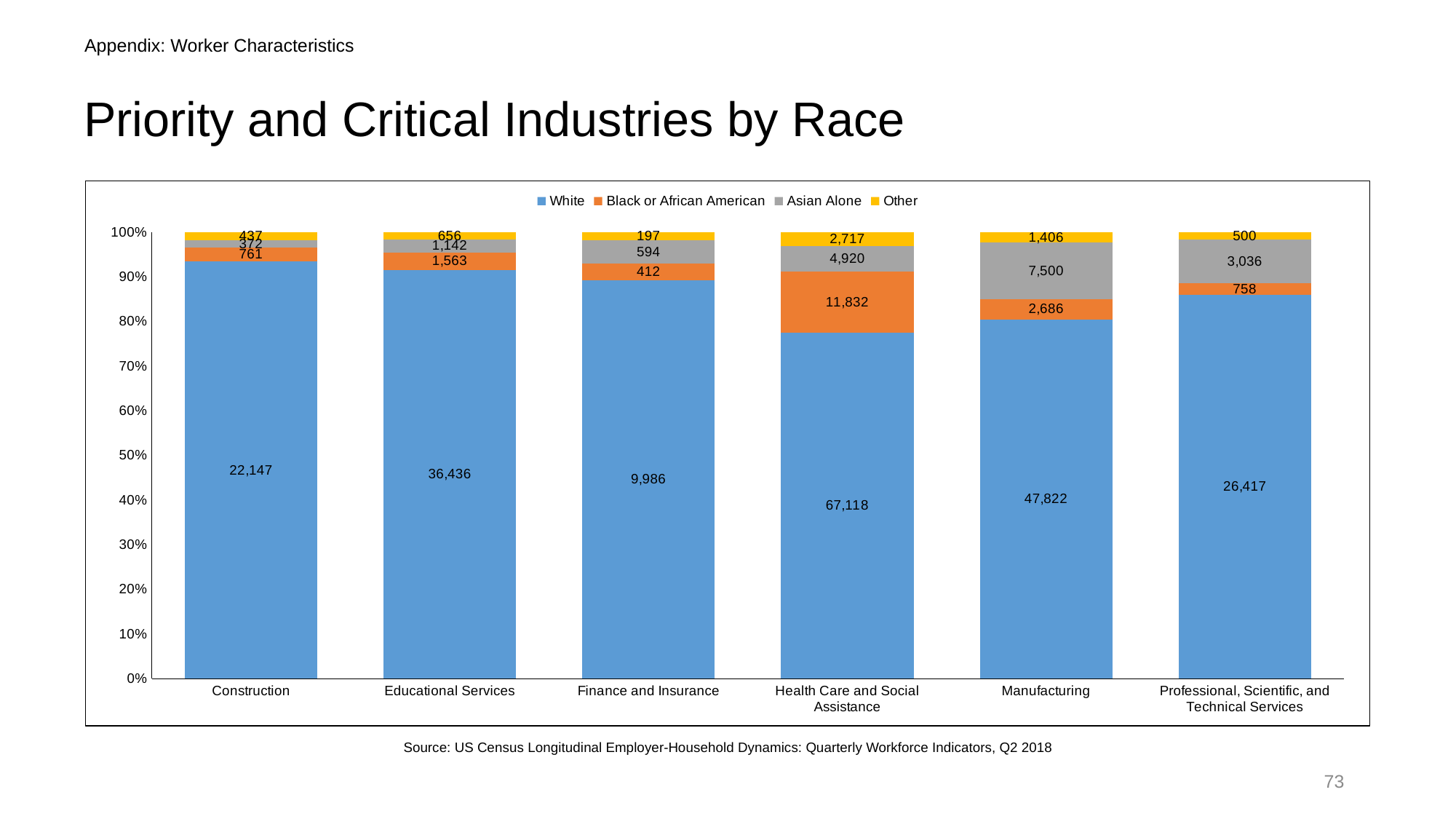
What kind of chart is shown on the slide? Stacked bar chart What is the value for White in Health Care and Social Assistance? 67,118 What is the value for Asian Alone in Manufacturing? 7,500 How many series does the legend list? 4 Which industry has the lowest value for Black or African American? Finance and Insurance What is the value for Black or African American in Educational Services? 1,563 What is the difference between the Asian Alone and Black or African American values in Manufacturing? 4,814 What is the total of all four series for Construction? 23,717 What is the value for Other in Finance and Insurance? 197 Which industry has the highest value for White? Health Care and Social Assistance How many industries are shown on the x axis? 6 Which is larger in Professional, Scientific, and Technical Services: Asian Alone or Black or African American? Asian Alone